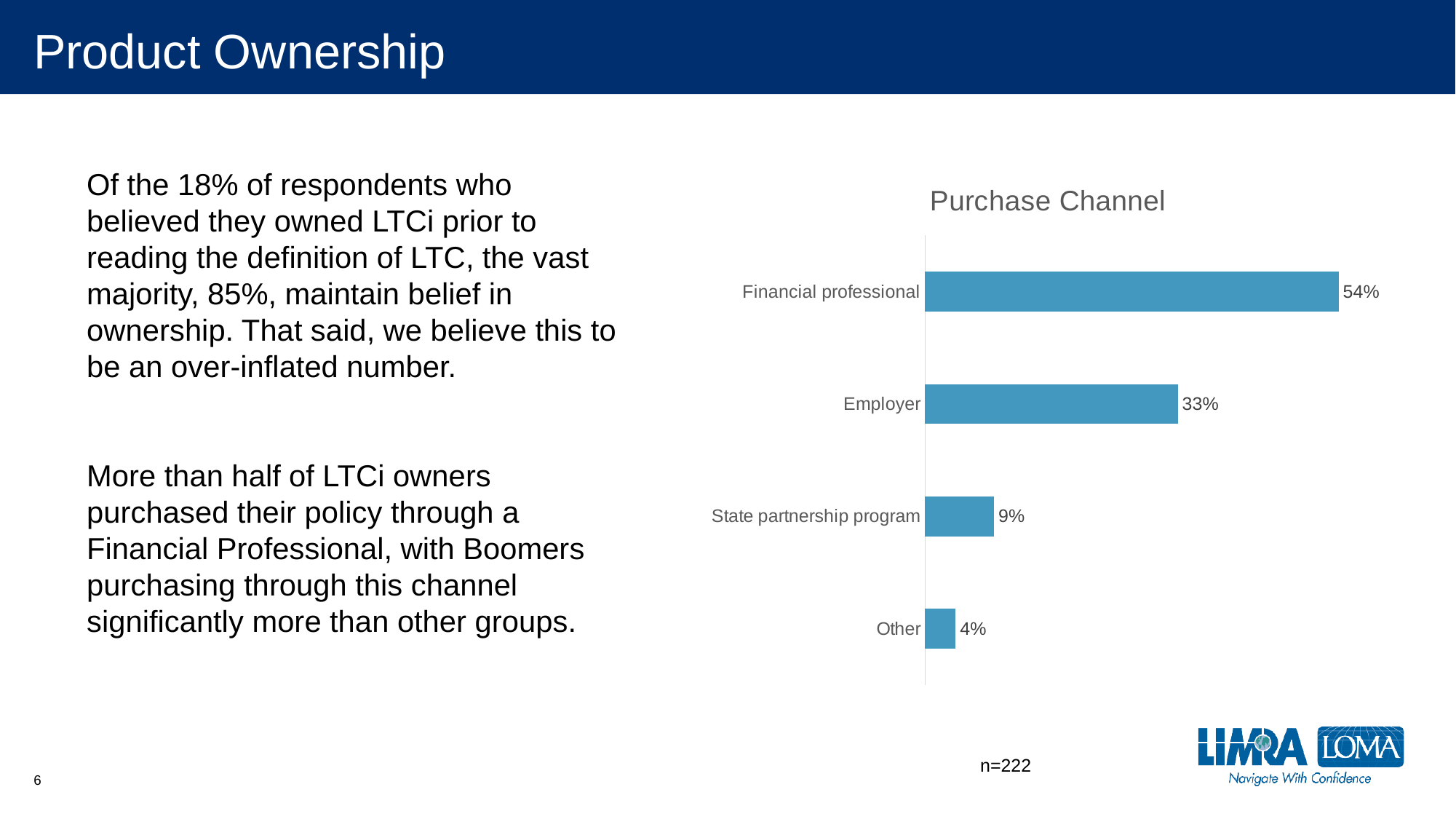
What is the value for State partnership program in the Purchase Channel chart? 9% Which purchase channel has the lowest value? Other What is the value for Financial professional in the Purchase Channel chart? 54% What is the difference between the State partnership program and Other values? 5% Which is larger, the value for Employer or the value for State partnership program? Employer How many purchase channels are shown in the chart? 4 What kind of chart is used to show Purchase Channel? Bar chart What is the value for Employer in the Purchase Channel chart? 33% Which purchase channel has the highest value? Financial professional What is the difference between the Financial professional and Employer values? 21% What is the value for Other in the Purchase Channel chart? 4% What is the title of the chart on the slide? Purchase Channel